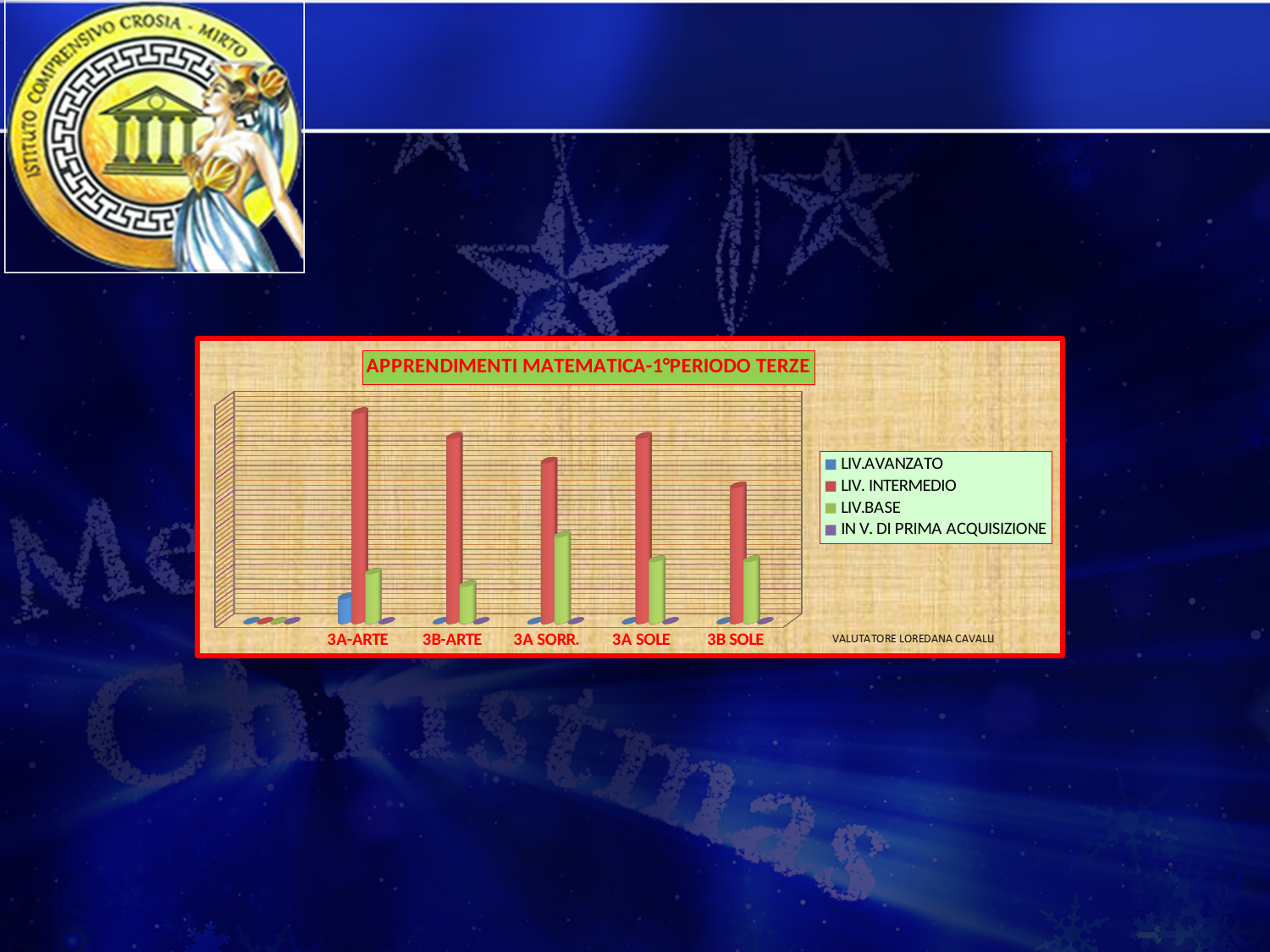
How many categories (classes) are shown on the x axis of the chart? 5 Which class has the highest LIV.BASE bar? 3A SORR. Which series has the tallest bar for the class 3A-ARTE? LIV. INTERMEDIO Which class has the lowest LIV. INTERMEDIO bar? 3B SOLE Is the LIV. INTERMEDIO bar larger for 3A-ARTE or for 3B SOLE? 3A-ARTE Which series is shown in red in the chart legend? LIV. INTERMEDIO Which class has the lowest LIV.BASE bar? 3B-ARTE What kind of chart is shown on the slide? bar chart Which class has the highest LIV. INTERMEDIO bar? 3A-ARTE Is the LIV.BASE bar larger for 3A SORR. or for 3B-ARTE? 3A SORR. How many series does the chart legend list? 4 What is the title of the chart? APPRENDIMENTI MATEMATICA-1°PERIODO TERZE